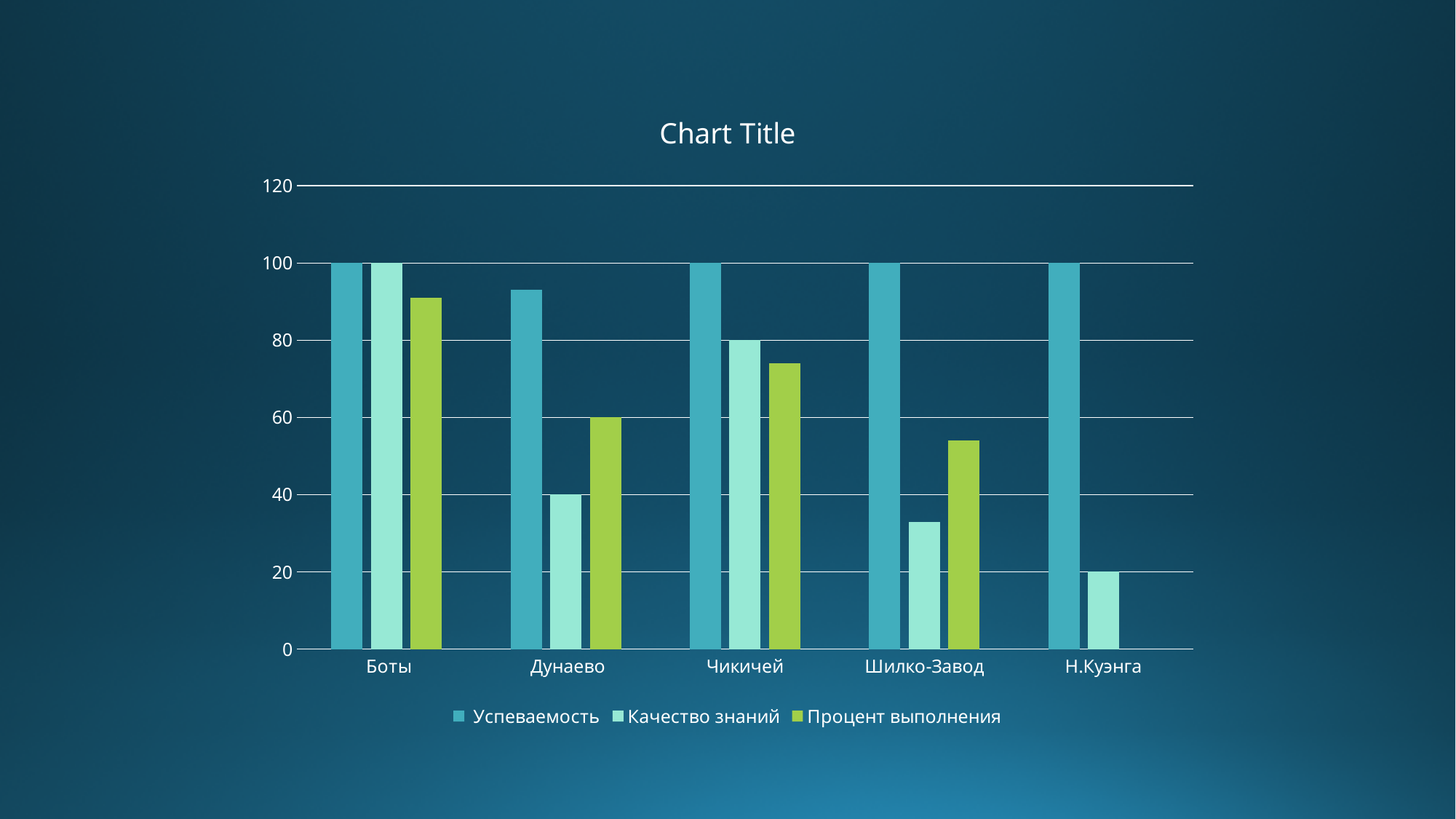
What is the value of Процент выполнения for Дунаево? 60 What is the value of Качество знаний for Чикичей? 80 How many categories are shown on the x axis? 5 What type of chart is shown on the slide? bar chart Which category has the highest value for Процент выполнения? Боты How many series does the legend list? 3 Which category has the lowest value for Качество знаний? Н.Куэнга What is the value of Качество знаний for Н.Куэнга? 20 What is the difference between Качество знаний for Чикичей and for Н.Куэнга? 60 What is the title of the chart? Chart Title Is the value of Качество знаний for Шилко-Завод greater or less than 40? less Is the value of Процент выполнения for Чикичей greater or less than 80? less